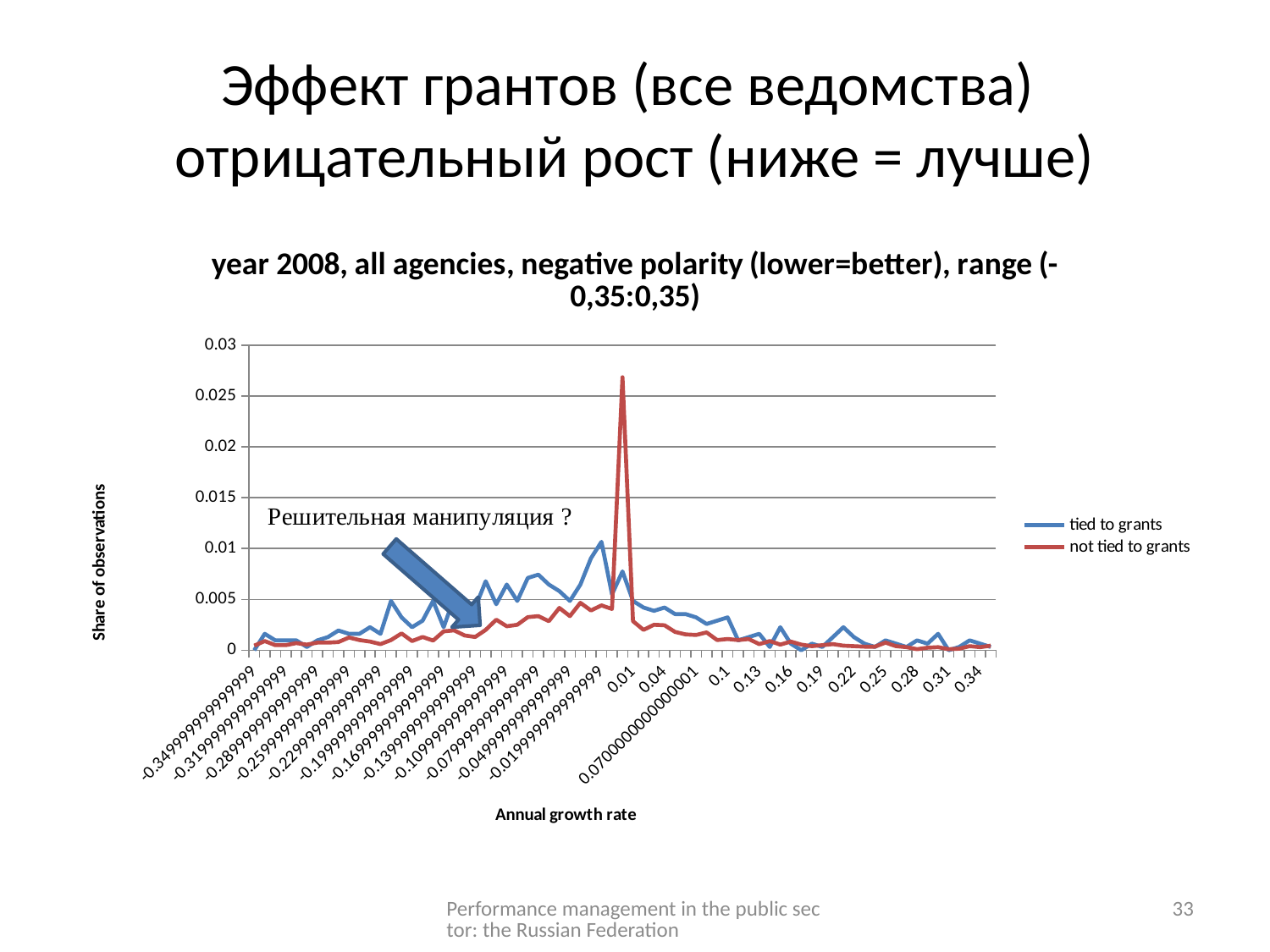
Between annual growth rates 0.1 and 0.34, do the values of the 'tied to grants' series generally rise or fall? fall At the annual growth rate of 0.01, which series has the larger share of observations: 'tied to grants' or 'not tied to grants'? tied to grants What is the highest tick value shown on the vertical axis? 0.03 What kind of chart is shown on the slide? line chart Is the peak value of the 'tied to grants' series greater or less than 0.015? less Is the value of the 'tied to grants' series at annual growth rate 0.34 greater or less than 0.005? less Is the peak value of the 'not tied to grants' series greater or less than 0.025? greater How many series does the legend list? 2 What is the label of the vertical axis? Share of observations Which series reaches the highest value anywhere on the chart? not tied to grants What are the two series named in the legend? tied to grants; not tied to grants